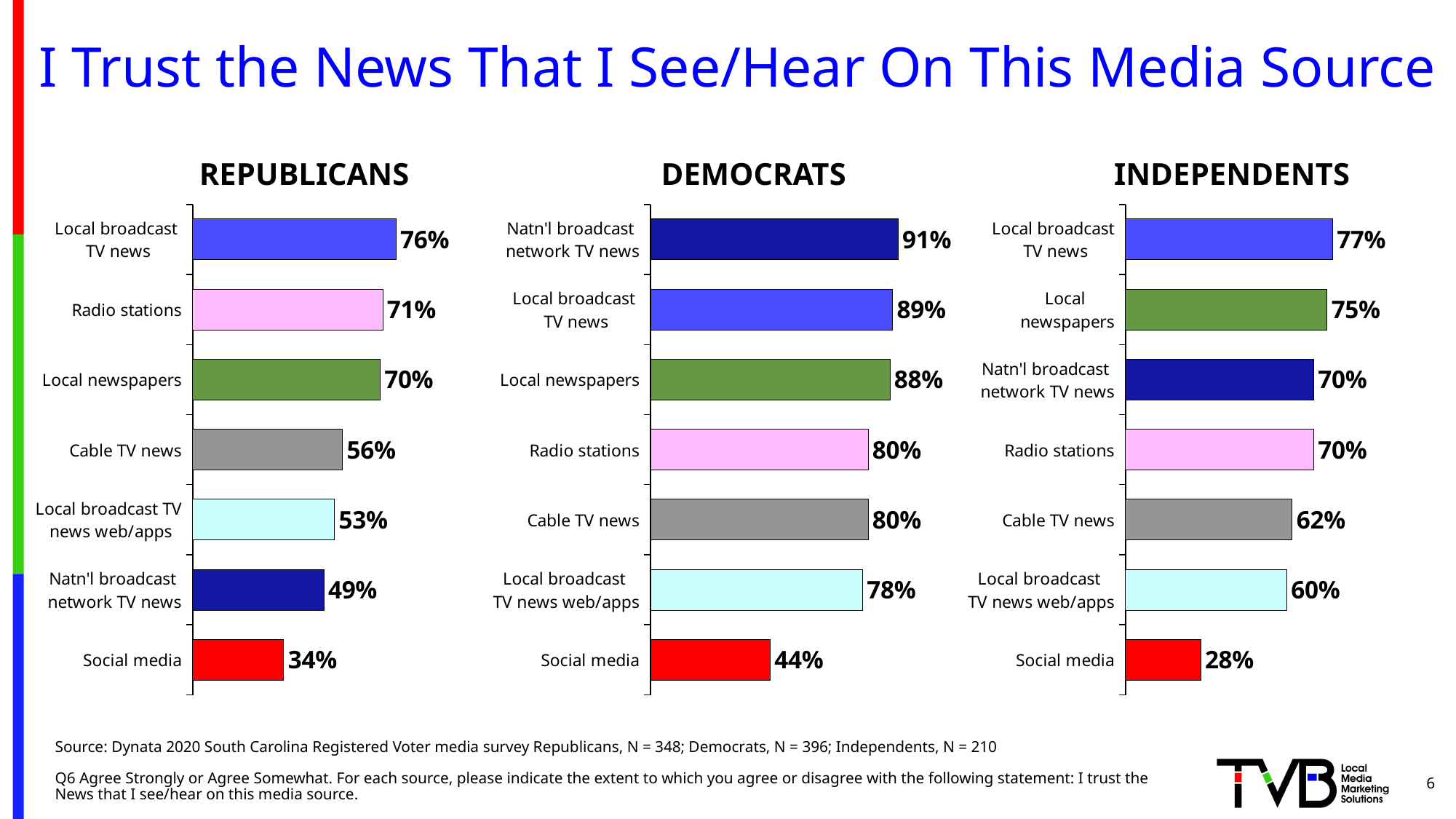
In the DEMOCRATS chart, which media source has the highest value? Natn'l broadcast network TV news How many charts are on the slide? 3 In the DEMOCRATS chart, what is the difference between Natn'l broadcast network TV news and Local broadcast TV news web/apps? 13% In the REPUBLICANS chart, what is the difference between Local broadcast TV news and Social media? 42% What kind of chart is the REPUBLICANS chart? Bar chart In the DEMOCRATS chart, what is the value for Social media? 44% In the INDEPENDENTS chart, which is larger: Local newspapers or Local broadcast TV news web/apps? Local newspapers In the REPUBLICANS chart, what is the value for Local broadcast TV news? 76% In the REPUBLICANS chart, which is larger: Cable TV news or Natn'l broadcast network TV news? Cable TV news In the INDEPENDENTS chart, what is the value for Cable TV news? 62% In the INDEPENDENTS chart, which media source has the lowest value? Social media How many media sources are shown in the DEMOCRATS chart? 7